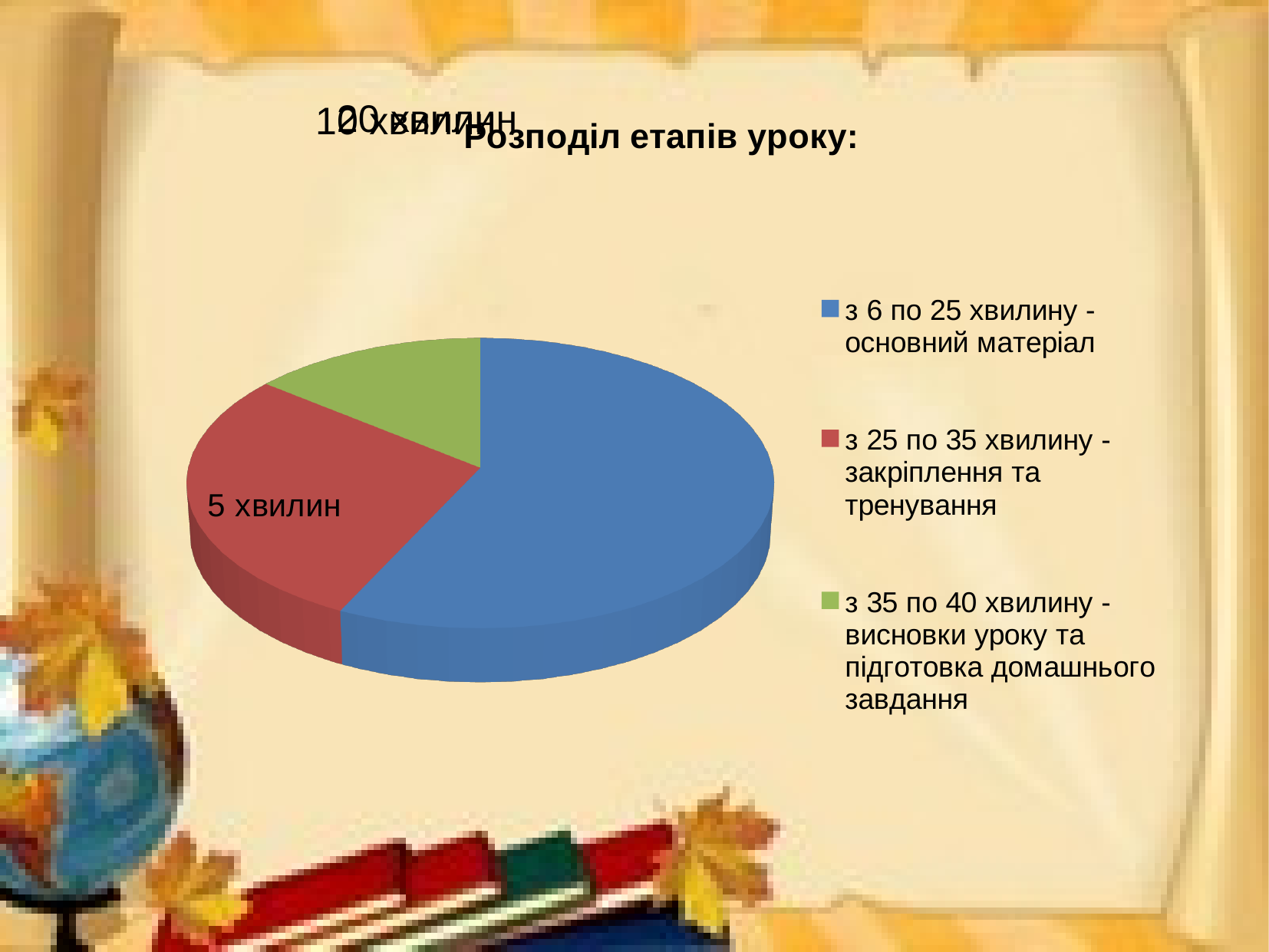
Which lesson stage takes the smallest share of the pie? з 35 по 40 хвилину - висновки уроку та підготовка домашнього завдання Which slice is larger: 'з 6 по 25 хвилину - основний матеріал' or 'з 25 по 35 хвилину - закріплення та тренування'? з 6 по 25 хвилину - основний матеріал What is the title of the chart? Розподіл етапів уроку: Which slice is larger: 'з 25 по 35 хвилину - закріплення та тренування' or 'з 35 по 40 хвилину - висновки уроку та підготовка домашнього завдання'? з 25 по 35 хвилину - закріплення та тренування Which lesson stage takes the largest share of the pie? з 6 по 25 хвилину - основний матеріал Is the slice for 'з 6 по 25 хвилину - основний матеріал' more or less than half of the pie? more What kind of chart is shown on the slide? pie chart How many entries does the legend list? 3 How many slices does the pie chart have? 3 What colour is the slice for 'з 25 по 35 хвилину - закріплення та тренування'? red